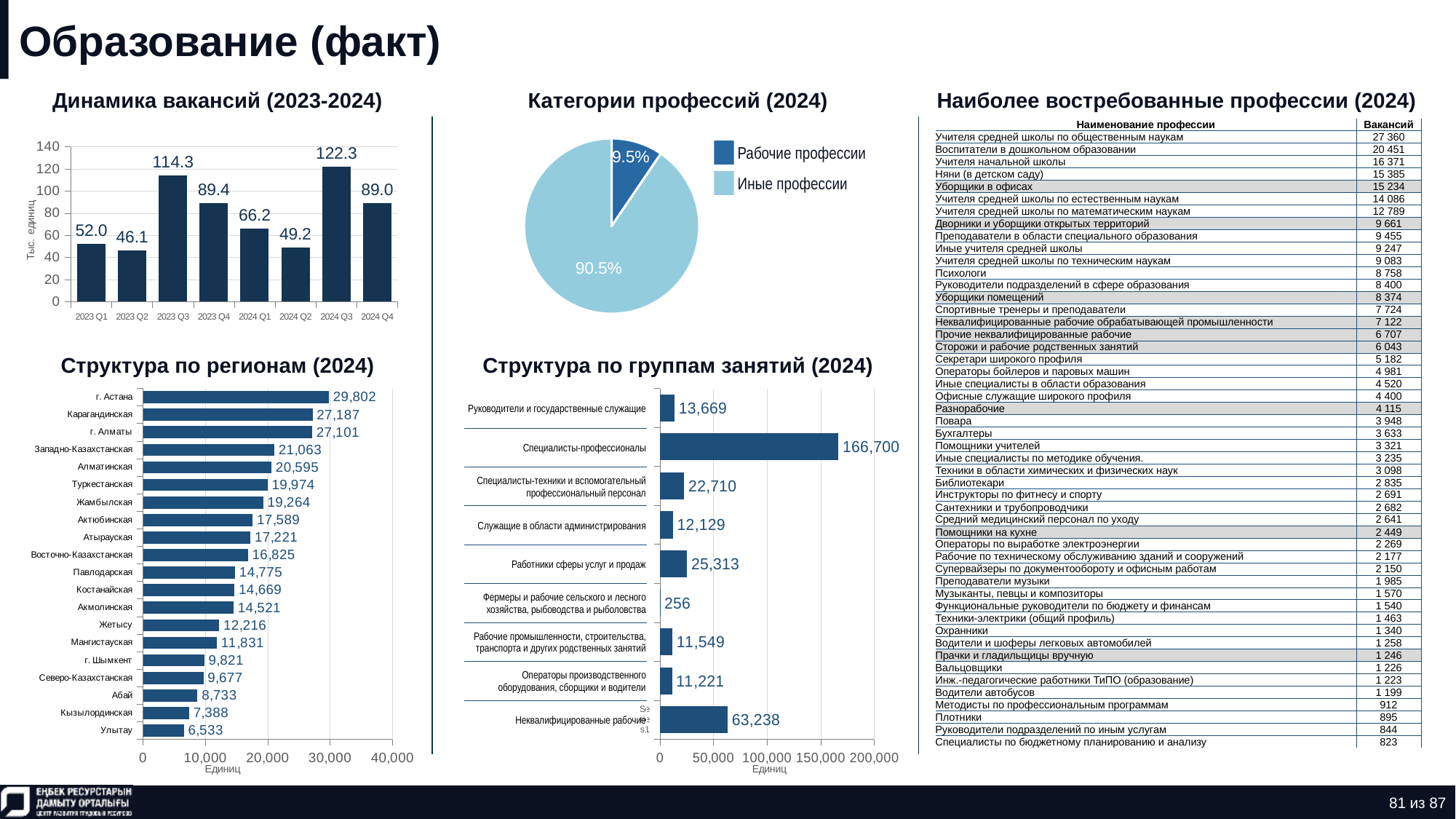
In the chart 'Динамика вакансий (2023-2024)', which quarter has the lowest value? 2023 Q2 In the chart 'Динамика вакансий (2023-2024)', how many quarters are plotted? 8 In the chart 'Структура по группам занятий (2024)', which group has the lowest value? Фермеры и рабочие сельского и лесного хозяйства, рыбоводства и рыболовства In the chart 'Динамика вакансий (2023-2024)', what is the value for 2024 Q3? 122.3 In the chart 'Структура по регионам (2024)', how many regions are listed? 20 In the chart 'Динамика вакансий (2023-2024)', what is the difference between 2023 Q3 and 2023 Q4? 24.9 In the chart 'Структура по регионам (2024)', what is the value for г. Алматы? 27,101 In the chart 'Структура по группам занятий (2024)', which is larger: 'Работники сферы услуг и продаж' or 'Служащие в области администрирования'? Работники сферы услуг и продаж What type of chart is 'Категории профессий (2024)'? Pie chart In the chart 'Структура по регионам (2024)', which region has the highest value? г. Астана In the chart 'Категории профессий (2024)', what share of the pie is 'Рабочие профессии'? 9.5% In the chart 'Структура по группам занятий (2024)', what is the value for 'Специалисты-профессионалы'? 166,700